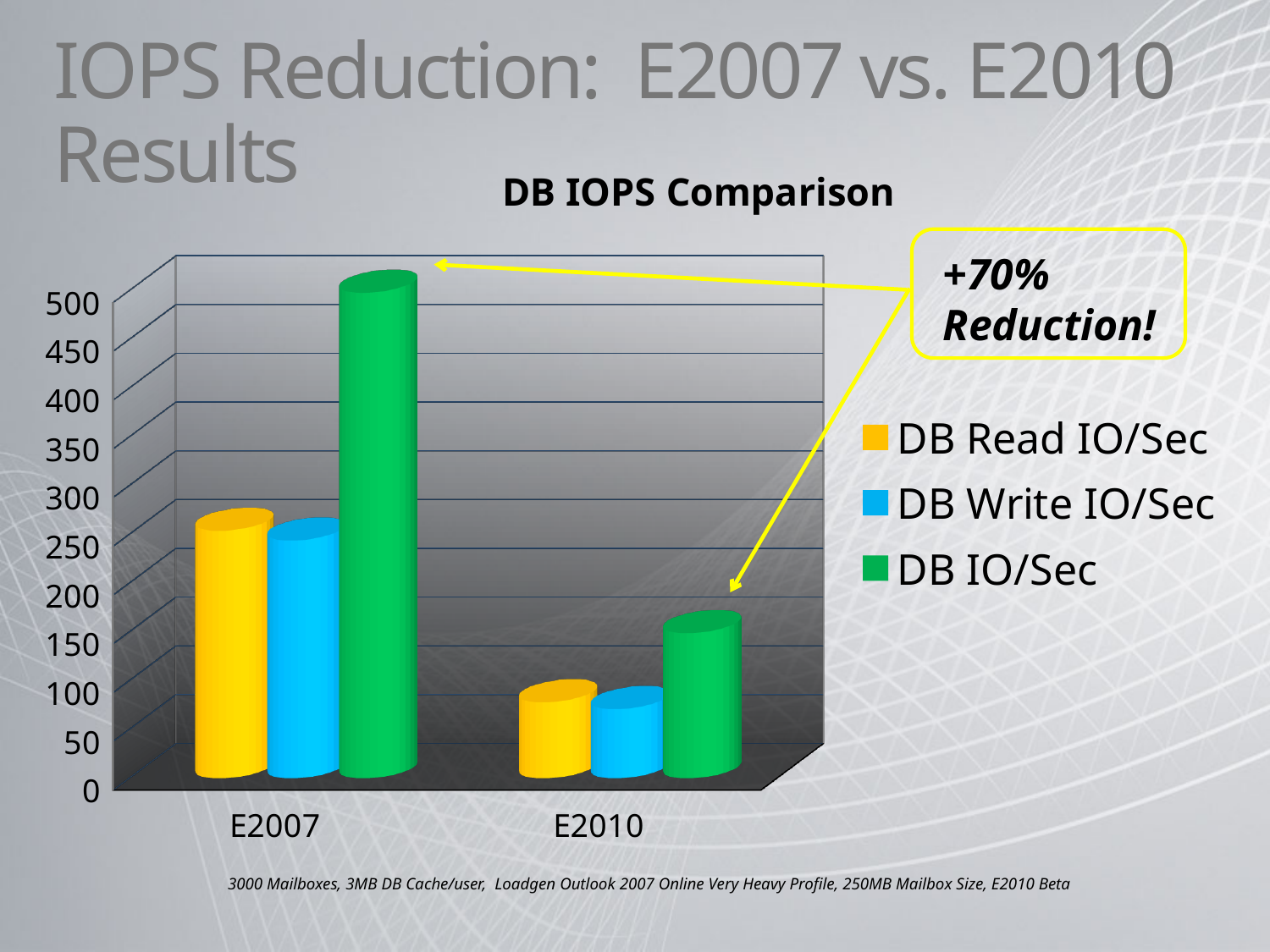
Is the DB IO/Sec value for E2007 greater or less than 400? greater What type of chart is shown on the slide? Bar chart Is the DB IO/Sec value for E2010 greater or less than 200? less Do the values rise or fall from E2007 to E2010? fall How many series does the legend list? 3 What reduction does the callout on the slide claim? +70% Reduction! Which bar is the highest in the chart? DB IO/Sec for E2007 Is the DB Read IO/Sec value for E2007 greater or less than 200? greater How many categories are shown on the x axis? 2 Which is larger, the DB IO/Sec value for E2007 or for E2010? E2007 What is the title of the chart? DB IOPS Comparison